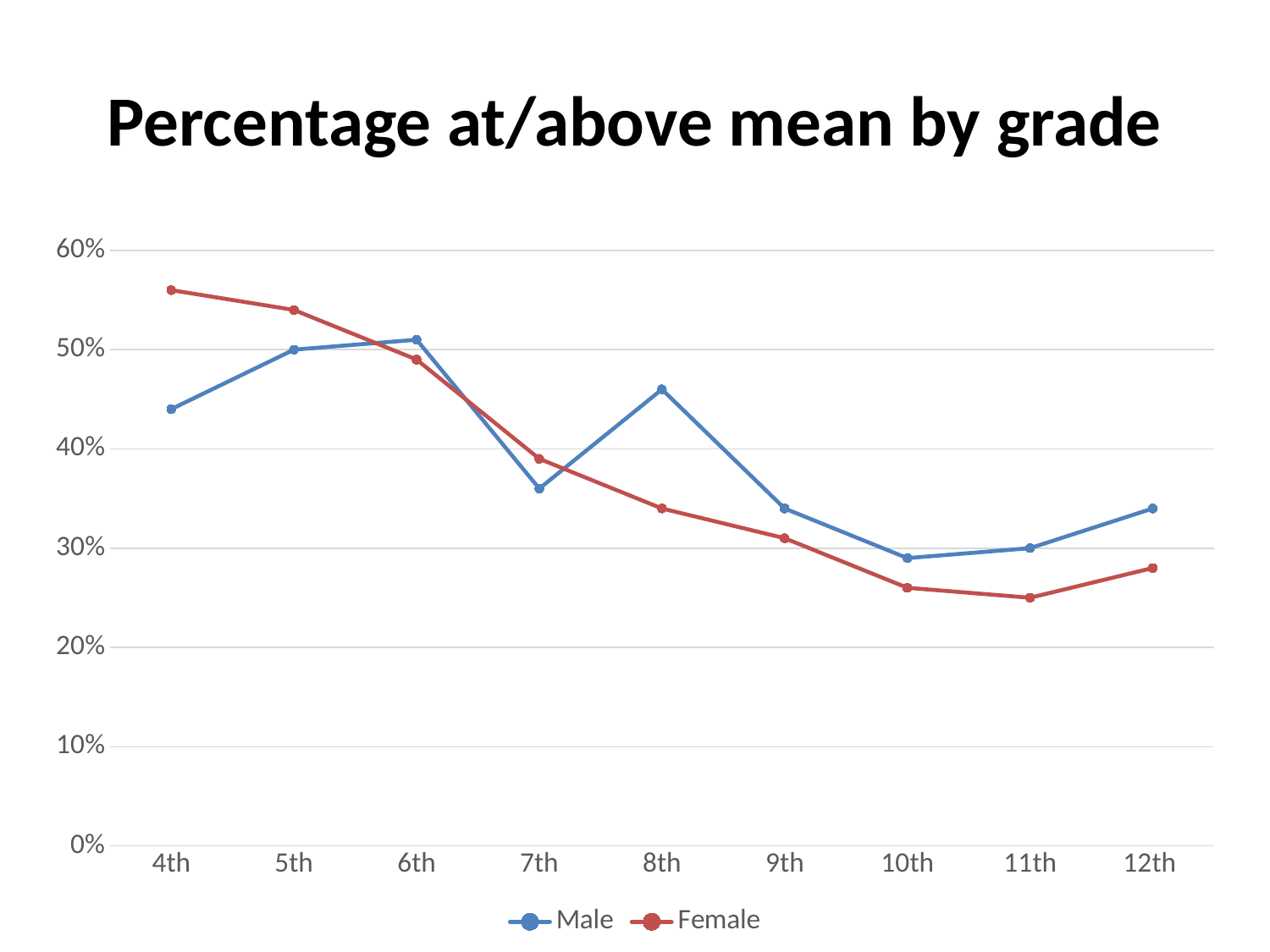
Is the Male value for 7th grade greater or less than 40%? less How many grade categories are plotted on the x axis? 9 Is the Female value for 11th grade greater or less than 30%? less At which grade is the Female series highest? 4th What is the title of the chart? Percentage at/above mean by grade Which colour is used for the Female series? red At 8th grade, which series has the higher value, Male or Female? Male Does the Female series generally rise or fall from 4th grade to 11th grade? fall Is the Male value for 8th grade greater or less than 40%? greater What kind of chart is shown on the slide? line chart How many series does the legend list? 2